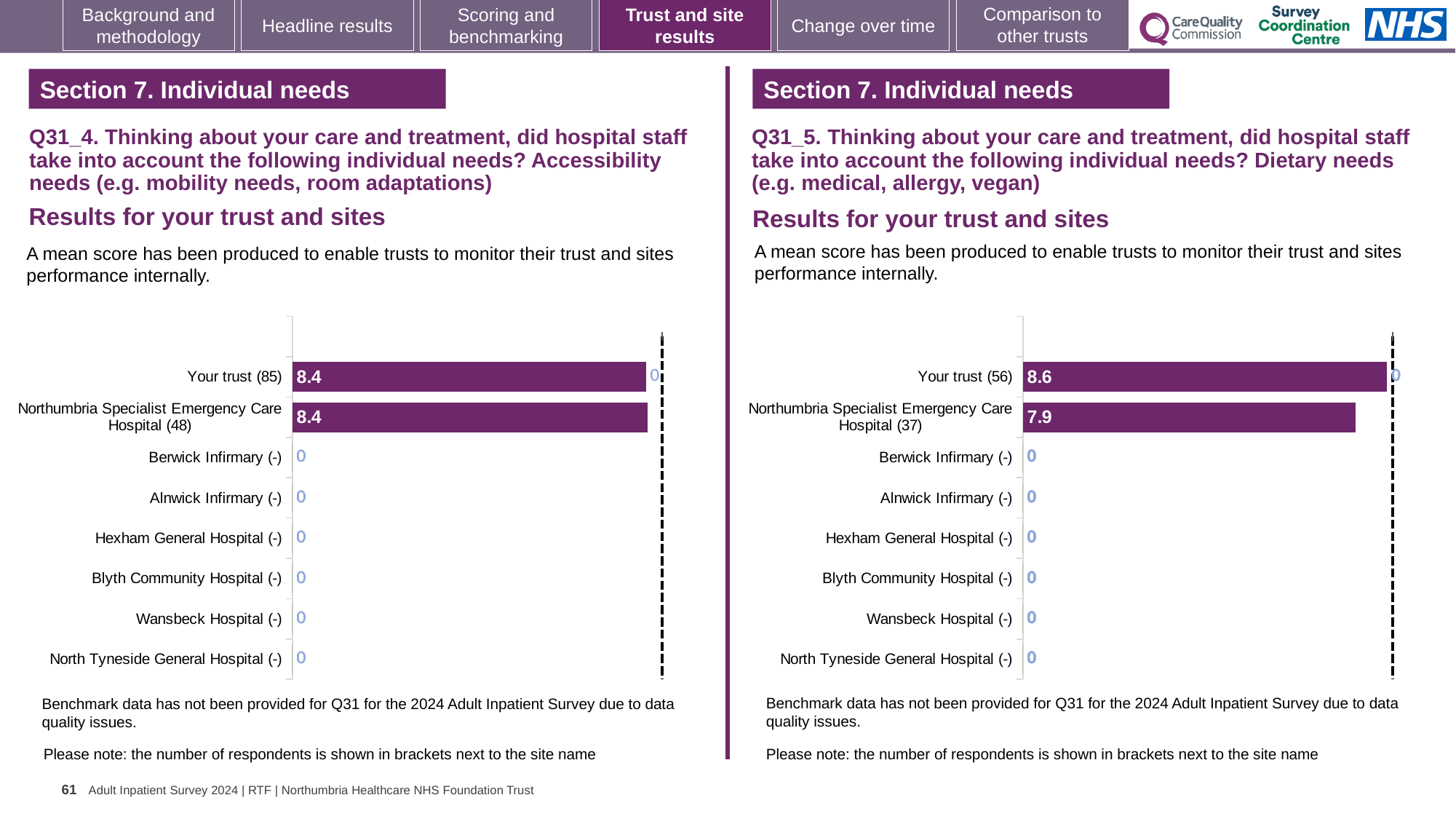
On the Q31_4 Accessibility needs chart (left), how many respondents are shown in brackets for Your trust? 85 On the Q31_4 Accessibility needs chart (left), what is the mean score for Your trust? 8.4 On the Q31_5 Dietary needs chart (right), which has the higher mean score: Your trust or Northumbria Specialist Emergency Care Hospital? Your trust How many categories are listed on the Q31_4 Accessibility needs chart (left)? 8 On the Q31_5 Dietary needs chart (right), how many respondents are shown in brackets for Northumbria Specialist Emergency Care Hospital? 37 On the Q31_5 Dietary needs chart (right), what is the mean score for Northumbria Specialist Emergency Care Hospital? 7.9 On the Q31_5 Dietary needs chart (right), which category has the highest mean score? Your trust (56) On the Q31_5 Dietary needs chart (right), what is the difference between the mean score for Your trust and the mean score for Northumbria Specialist Emergency Care Hospital? 0.7 On the Q31_4 Accessibility needs chart (left), what is the mean score for Northumbria Specialist Emergency Care Hospital? 8.4 What type of chart is used for the Q31_5 Dietary needs results (right)? Bar chart On the Q31_5 Dietary needs chart (right), what is the mean score for Your trust? 8.6 On the Q31_4 Accessibility needs chart (left), what value is shown for Berwick Infirmary? 0